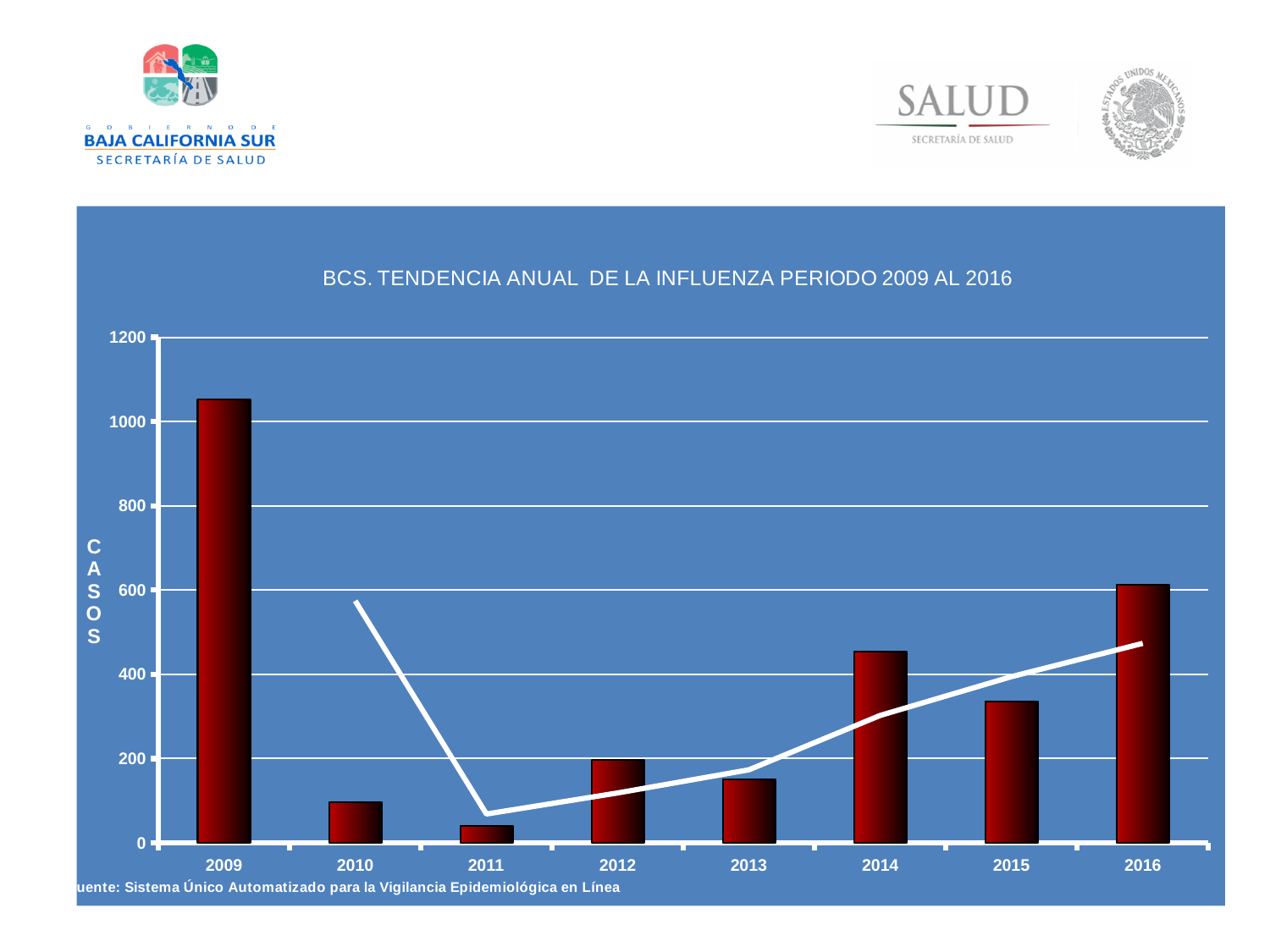
What is the title of the chart? BCS. TENDENCIA ANUAL DE LA INFLUENZA PERIODO 2009 AL 2016 Is the value for 2015 greater or less than 400? less Do the values rise or fall from 2009 to 2011? fall Is the value for 2010 greater or less than 200? less Which year has more cases, 2014 or 2015? 2014 Is the value for 2009 greater or less than 1000? greater How many years are shown on the x axis of the chart? 8 Which year has the lowest number of cases? 2011 Which year has more cases, 2012 or 2013? 2012 Which year has the highest number of cases? 2009 What kind of chart is shown on the slide? bar chart